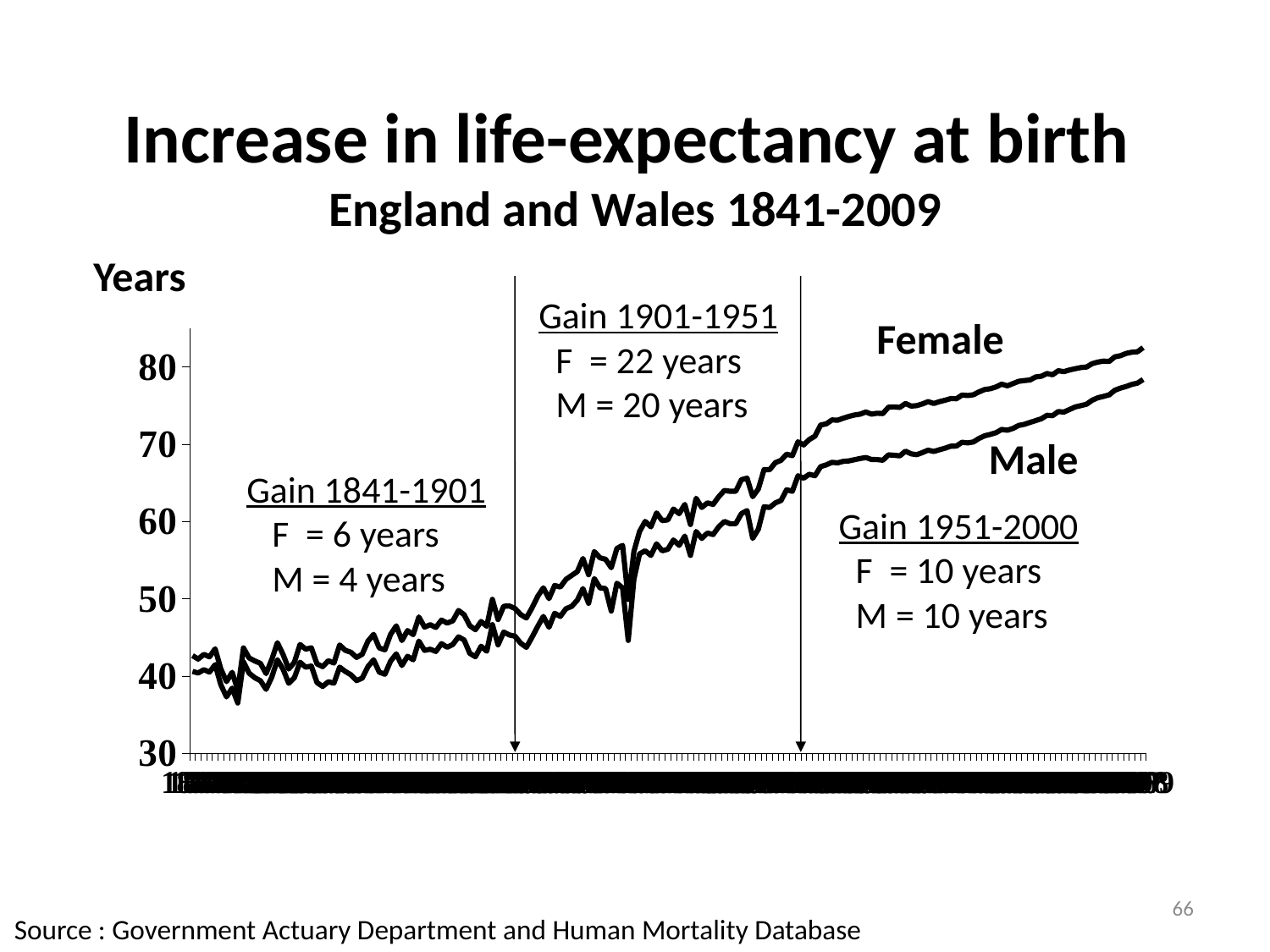
What kind of chart is shown on the slide? line chart How many series are plotted on the chart? 2 According to the annotation, what was the male gain in life expectancy from 1841 to 1901? 4 years Is the Male value at the right-hand end of the chart greater or less than 80? less According to the annotation, what was the male gain in life expectancy from 1901 to 1951? 20 years What unit is shown on the y axis of the chart? Years Is the Male value at the left-hand start of the chart greater or less than 50? less Which series is higher at the right-hand end of the chart, Female or Male? Female What are the two series plotted on the chart? Female and Male According to the annotation, what was the female gain in life expectancy from 1951 to 2000? 10 years Do the life-expectancy values rise or fall over time along the x axis? rise According to the annotation, what was the female gain in life expectancy from 1901 to 1951? 22 years